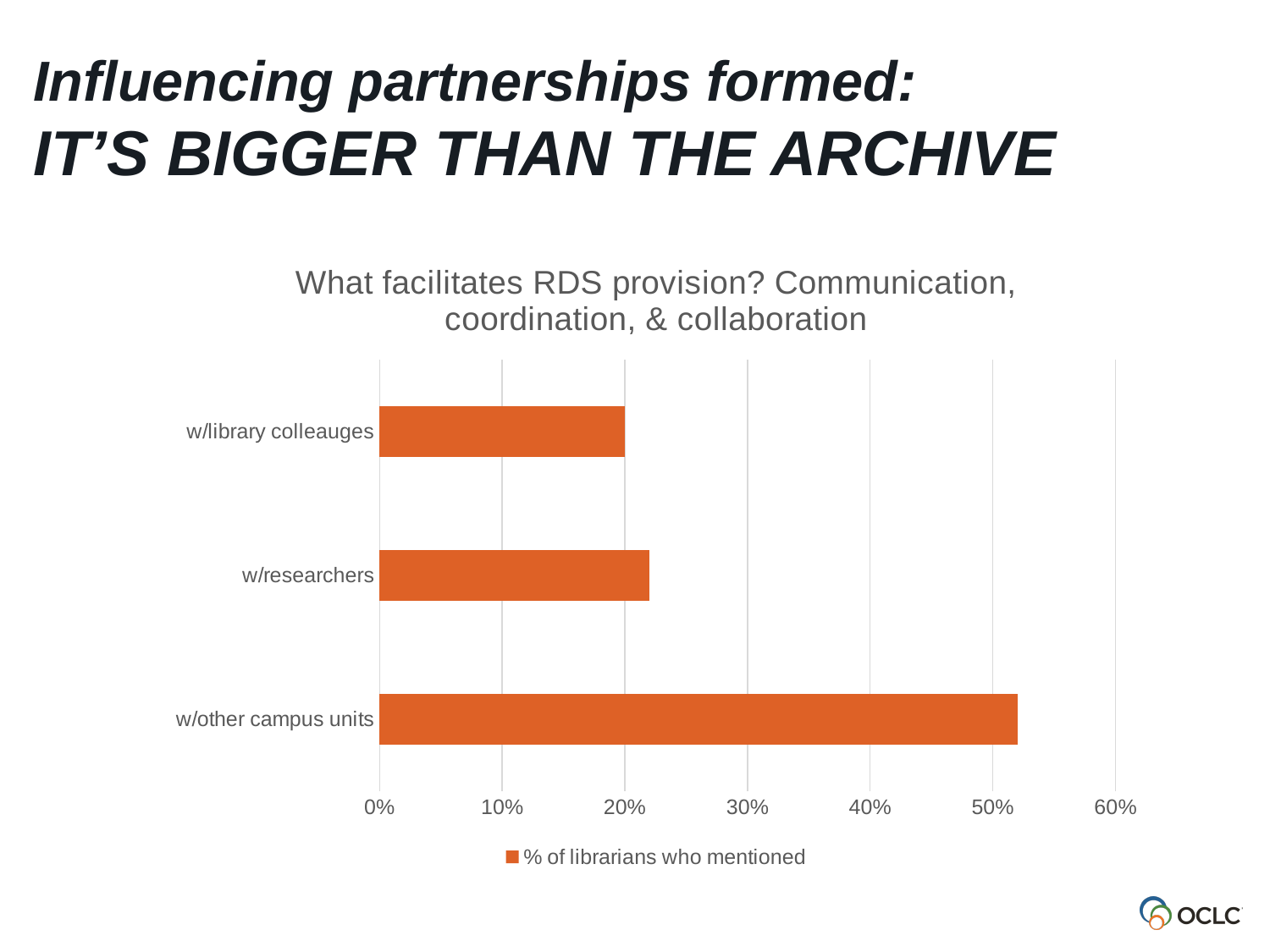
Is the value for w/other campus units greater or less than 50%? greater Is the value for w/other campus units greater or less than 60%? less Which is larger, the value for w/researchers or the value for w/other campus units? w/other campus units What type of chart is shown on the slide? bar chart What is the value for w/library colleauges? 20% What is the title of the chart? What facilitates RDS provision? Communication, coordination, & collaboration Which category has the lowest value? w/library colleauges Is the value for w/researchers greater or less than 30%? less Which category has the highest value? w/other campus units How many series does the legend list? 1 What is the legend entry for the series in the chart? % of librarians who mentioned How many categories are plotted in the chart? 3